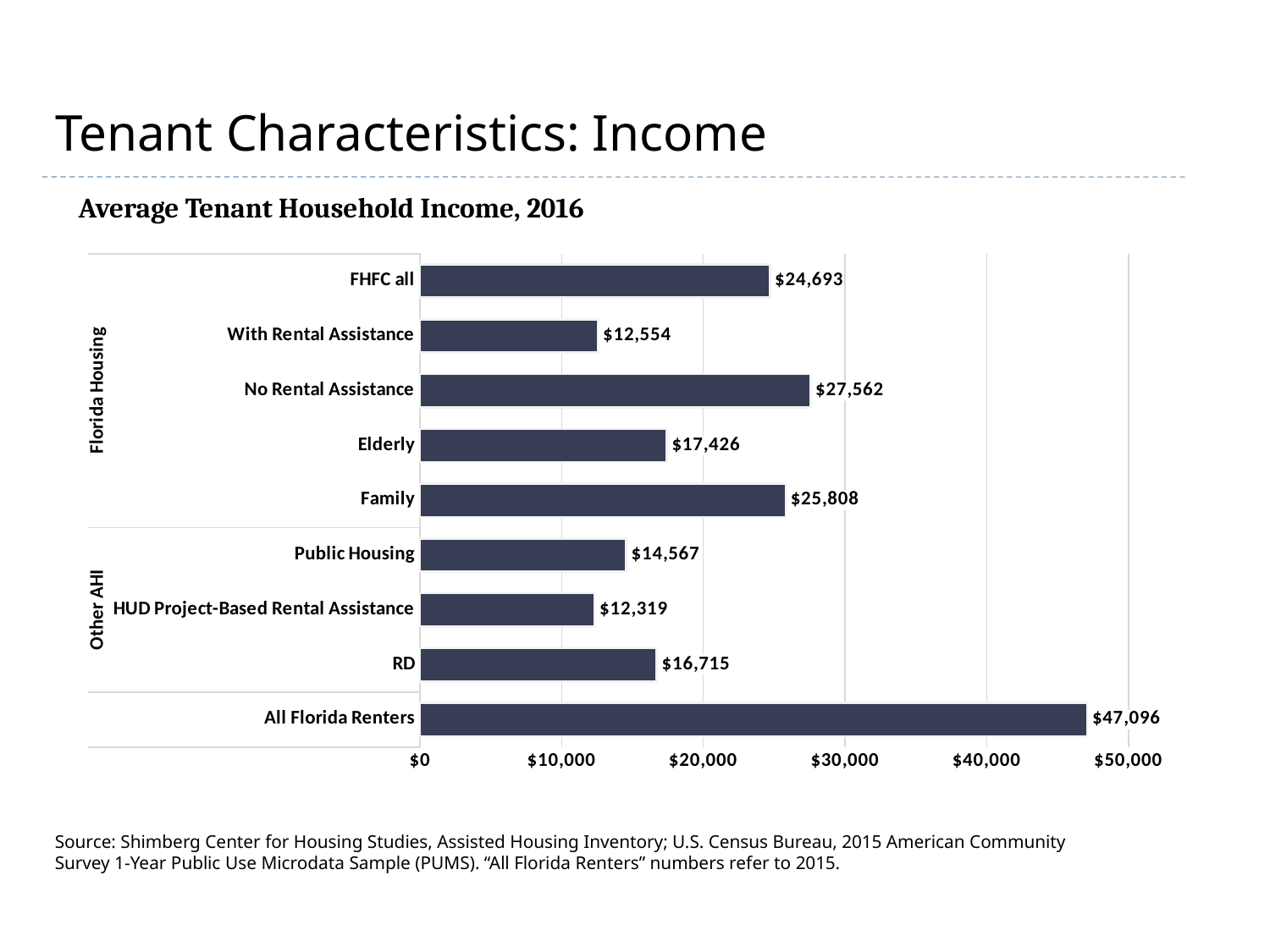
What is the average tenant household income for FHFC all? $24,693 Which has a higher average household income, Elderly or Family? Family What is the difference in average household income between All Florida Renters and FHFC all? $22,403 Which category has the lowest average tenant household income? HUD Project-Based Rental Assistance Which category has the highest average tenant household income? All Florida Renters How many categories are shown in the chart? 9 What is the average tenant household income for Public Housing? $14,567 What is the difference in average household income between No Rental Assistance and With Rental Assistance? $15,008 What is the average tenant household income for HUD Project-Based Rental Assistance? $12,319 What kind of chart is shown on the slide? bar chart Is the value for RD greater or less than $20,000? less What is the title of the chart? Average Tenant Household Income, 2016